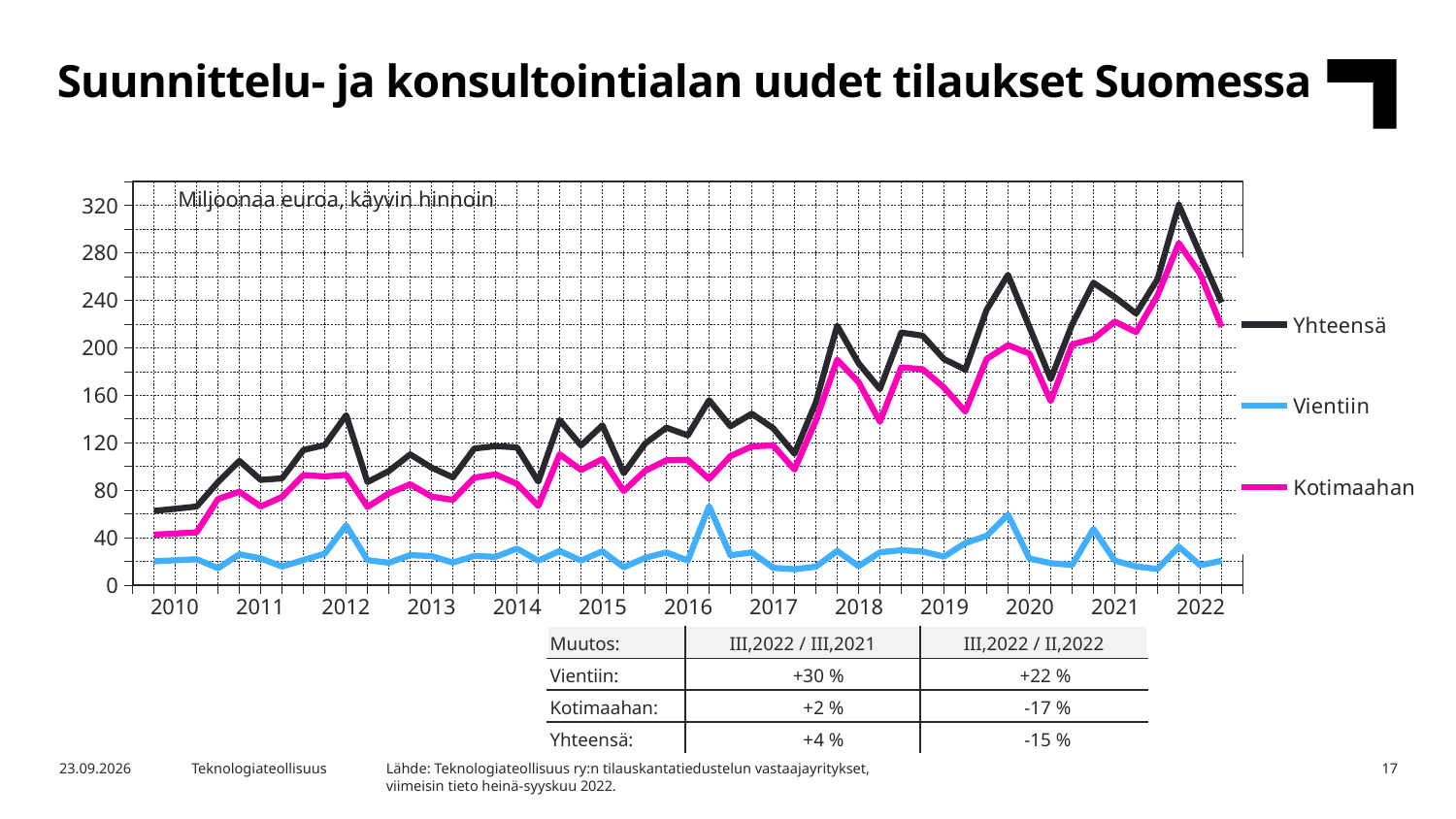
What unit label is printed inside the chart area? Miljoonaa euroa, käyvin hinnoin Which series has the lowest values throughout the chart? Vientiin Which series is plotted with the blue line? Vientiin What kind of chart is shown on the slide? line chart Which series has the highest values throughout the chart? Yhteensä Is the value of Kotimaahan at the last point in 2022 greater or less than 240? less Is the peak value of Vientiin in 2016 greater or less than 40? greater Is the value of Yhteensä at the start of 2010 greater or less than 80? less Does the Yhteensä series overall rise or fall from 2010 to 2022? rise How many series does the chart legend list? 3 Which series is larger in 2020, Kotimaahan or Vientiin? Kotimaahan